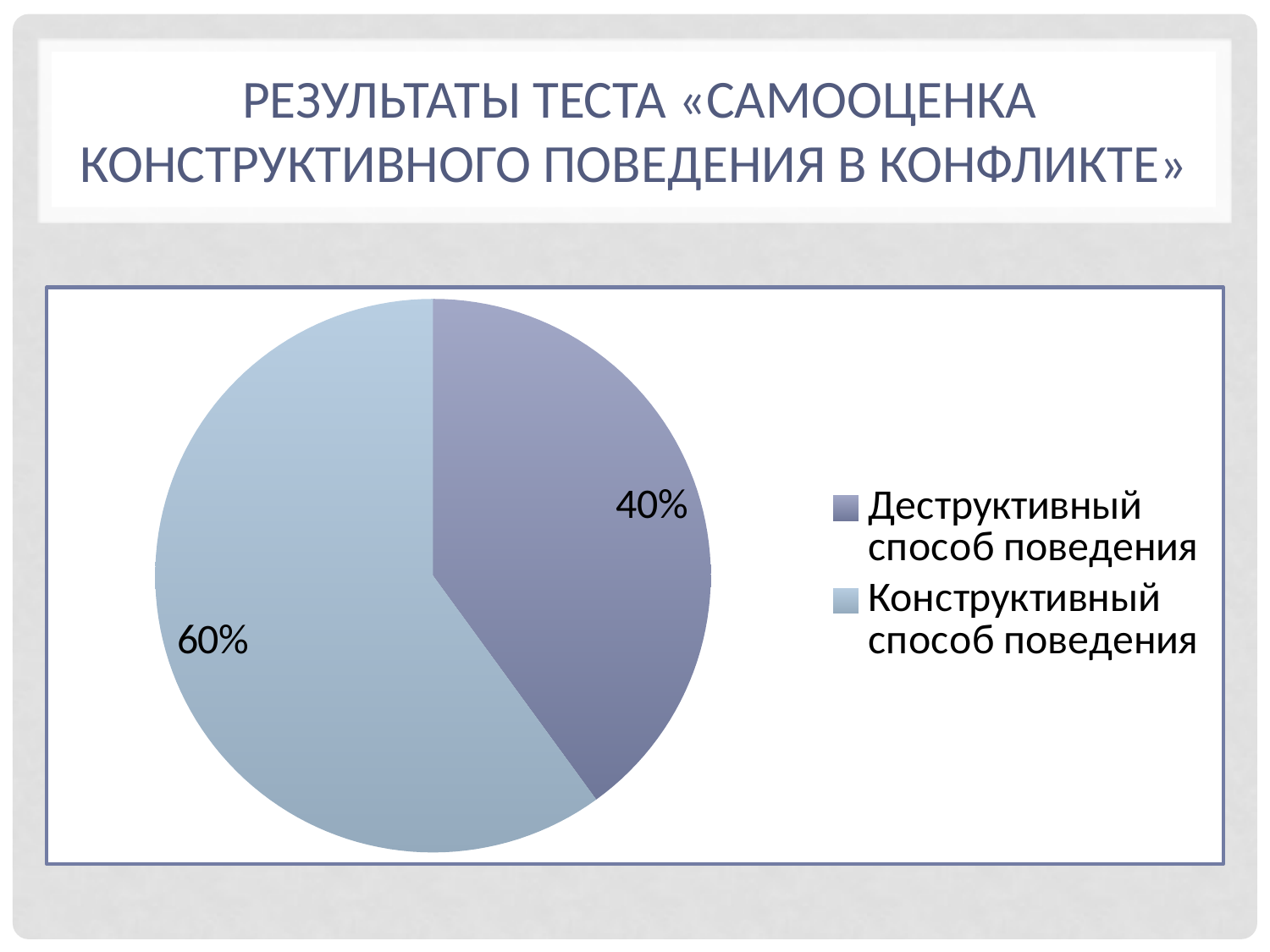
What share of the pie does "Деструктивный способ поведения" have? 40% What is the title of the slide containing the chart? Результаты теста «Самооценка конструктивного поведения в конфликте» What share of the pie does "Конструктивный способ поведения" have? 60% Which legend entry is shown in the darker blue-purple colour? Деструктивный способ поведения How many slices does the pie chart have? 2 What is the difference in percentage points between "Конструктивный способ поведения" and "Деструктивный способ поведения"? 20% What kind of chart is shown on the slide? pie chart Which is larger: the slice for "Деструктивный способ поведения" or the slice for "Конструктивный способ поведения"? Конструктивный способ поведения Which category has the largest slice of the pie? Конструктивный способ поведения Which category has the smallest slice of the pie? Деструктивный способ поведения How many entries does the legend list? 2